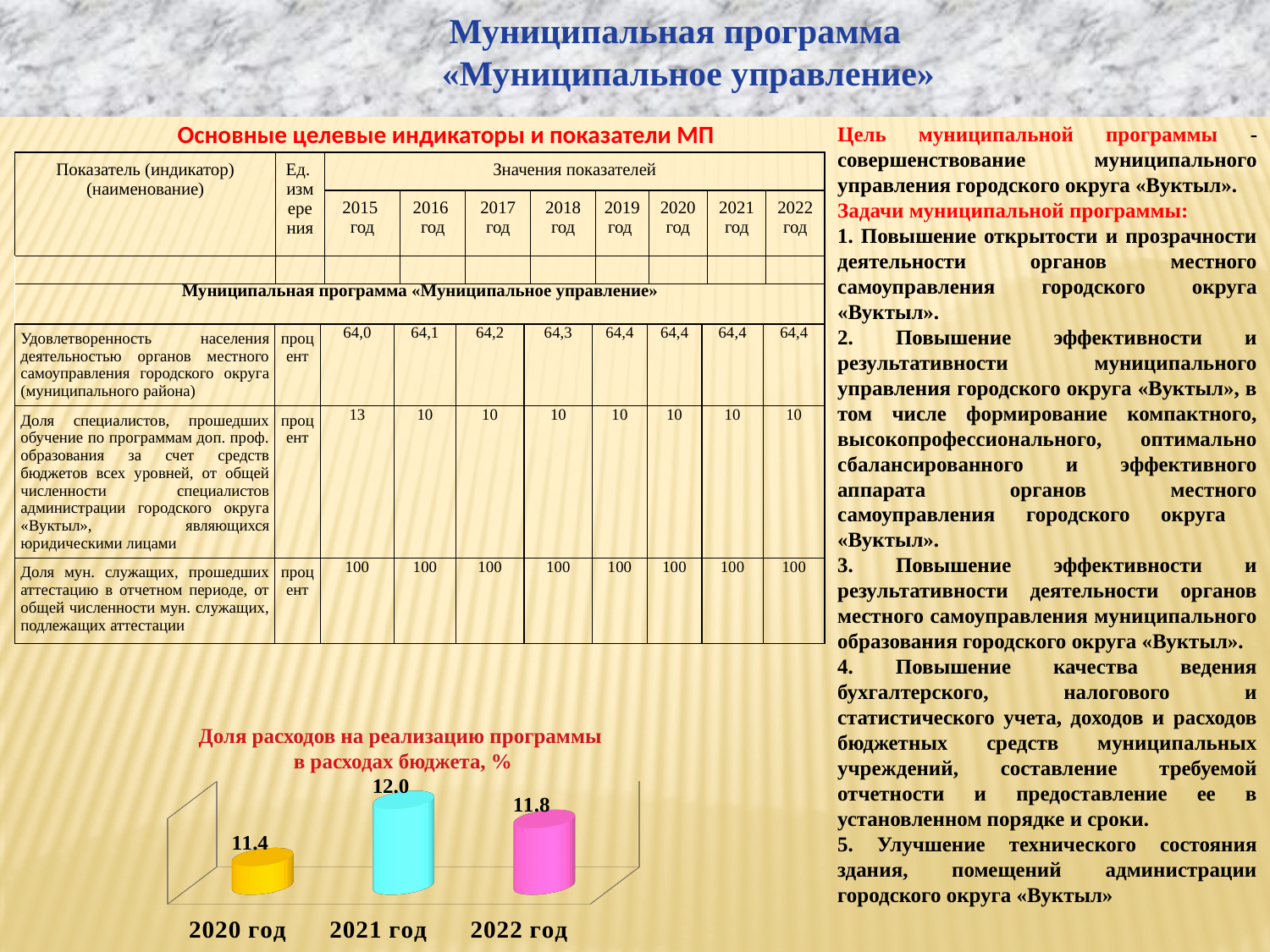
What is the value for 2020 год in the chart? 11.4 What is the difference between the values for 2021 год and 2022 год? 0.2 What kind of chart is shown on the slide? bar chart What is the title of the chart on the slide? Доля расходов на реализацию программы в расходах бюджета, % What is the value for 2021 год in the chart 'Доля расходов на реализацию программы в расходах бюджета, %'? 12.0 Which year has the lowest value in the chart? 2020 год Which is larger, the value for 2022 год or the value for 2020 год? 2022 год What is the difference between the values for 2021 год and 2020 год? 0.6 Does the value rise or fall from 2020 год to 2021 год? rise How many categories (years) are shown in the chart? 3 What is the value for 2022 год in the chart? 11.8 Which year has the highest value in the chart? 2021 год